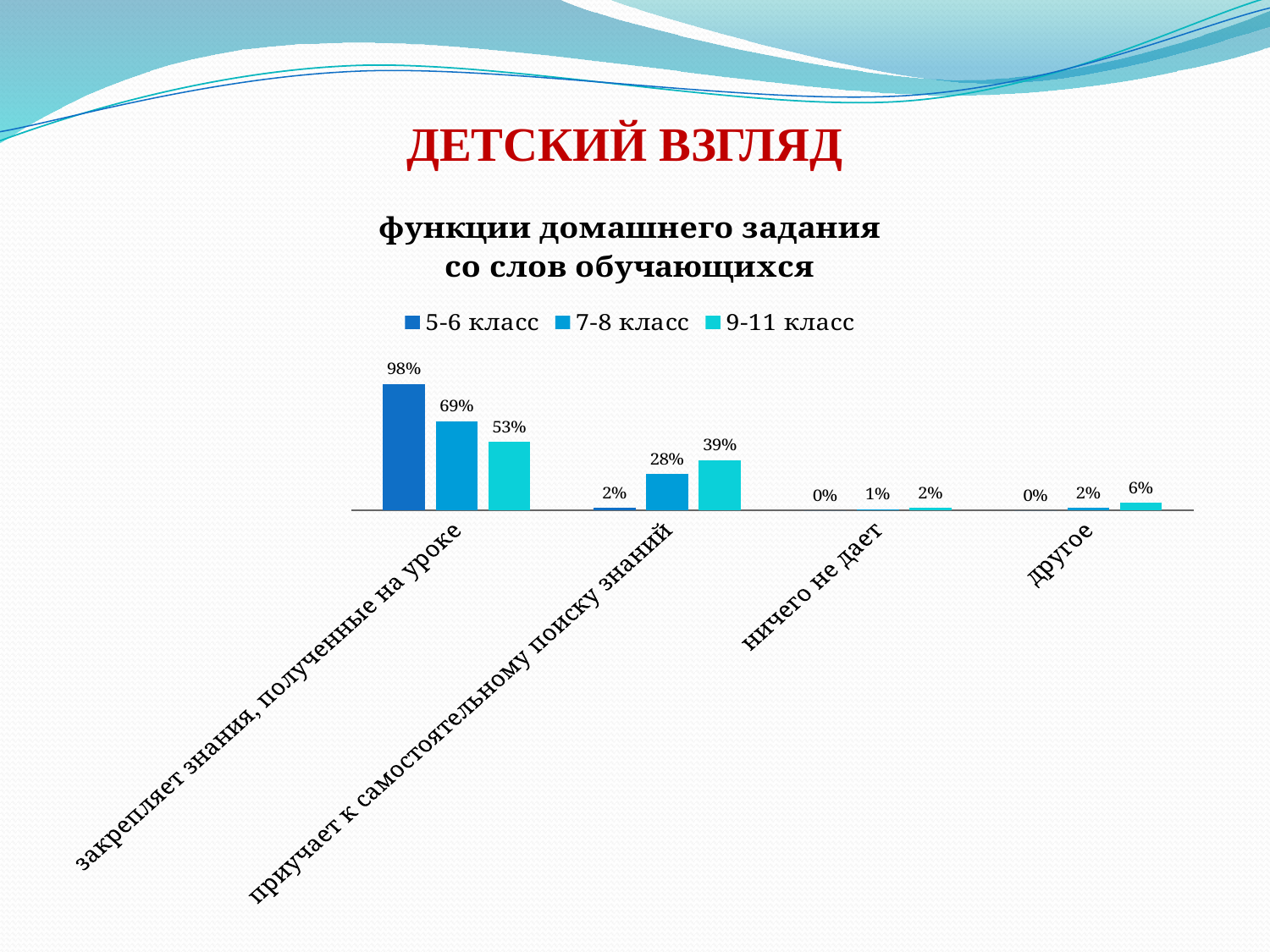
What is the value for 9-11 класс in the category 'другое'? 6% How many categories are shown on the x axis? 4 What kind of chart is shown on the slide? bar chart What is the title of the chart? функции домашнего задания со слов обучающихся What is the value for 5-6 класс in the category 'закрепляет знания, полученные на уроке'? 98% What is the value for 7-8 класс in the category 'ничего не дает'? 1% Which is larger in the category 'приучает к самостоятельному поиску знаний': the value for 7-8 класс or for 9-11 класс? 9-11 класс Which category has the highest value for 5-6 класс? закрепляет знания, полученные на уроке What is the difference between the 5-6 класс and 7-8 класс values in the category 'закрепляет знания, полученные на уроке'? 29% What is the value for 9-11 класс in the category 'приучает к самостоятельному поиску знаний'? 39% Which series has the lowest value in the category 'закрепляет знания, полученные на уроке'? 9-11 класс How many series does the legend list? 3